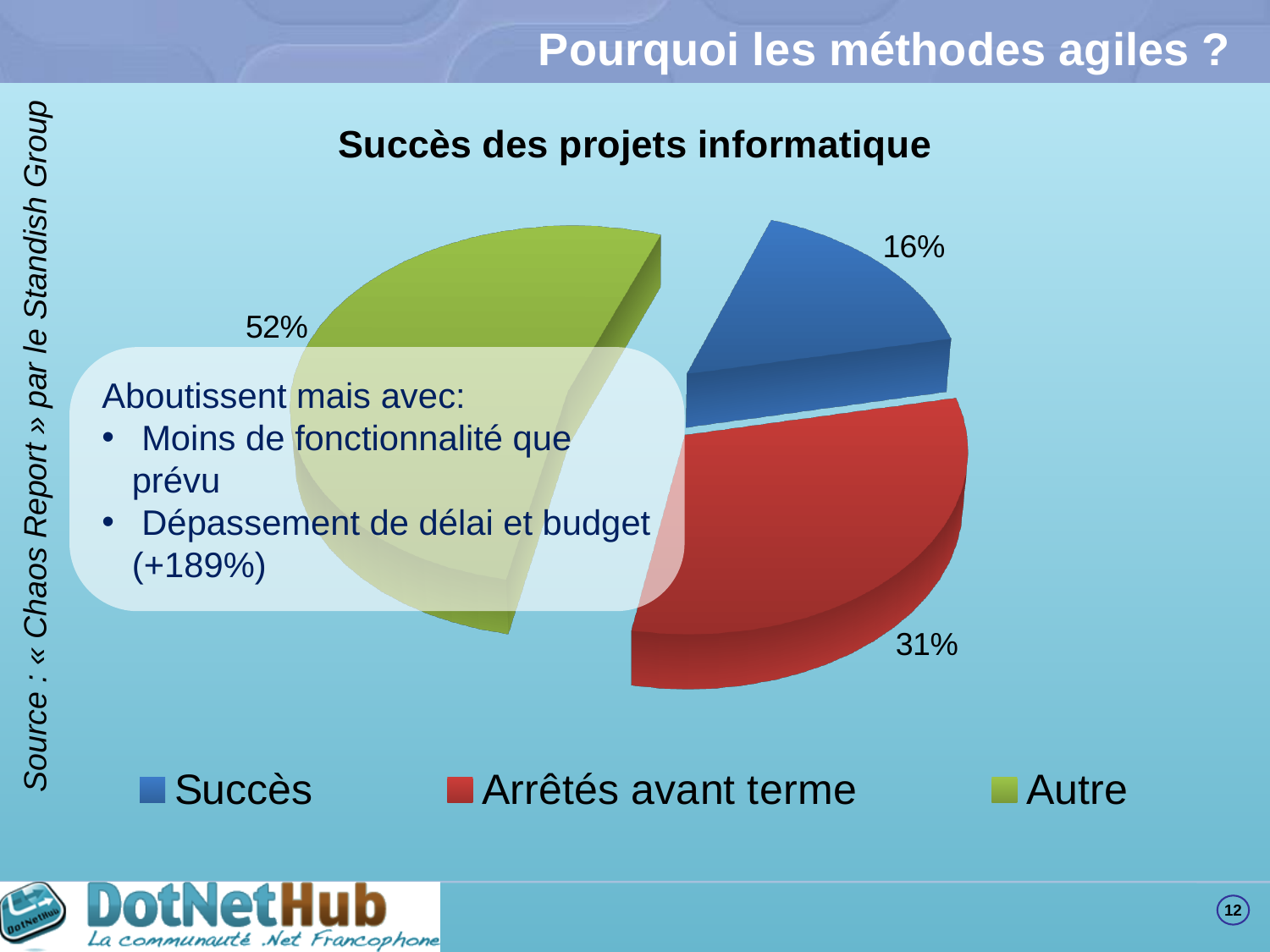
What type of chart is shown on the slide? Pie chart What is the difference in percentage points between Autre and Succès? 36 How many slices does the pie chart have? 3 What colour is the slice for Arrêtés avant terme? Red What percentage of the pie is labelled for Succès? 16% What is the title of the chart? Succès des projets informatique Which is larger, the share for Arrêtés avant terme or the share for Succès? Arrêtés avant terme What is the difference in percentage points between Arrêtés avant terme and Succès? 15 What percentage of the pie is labelled for Arrêtés avant terme? 31% Which category has the largest share of the pie? Autre What percentage of the pie is labelled for Autre? 52% Which category has the smallest share of the pie? Succès